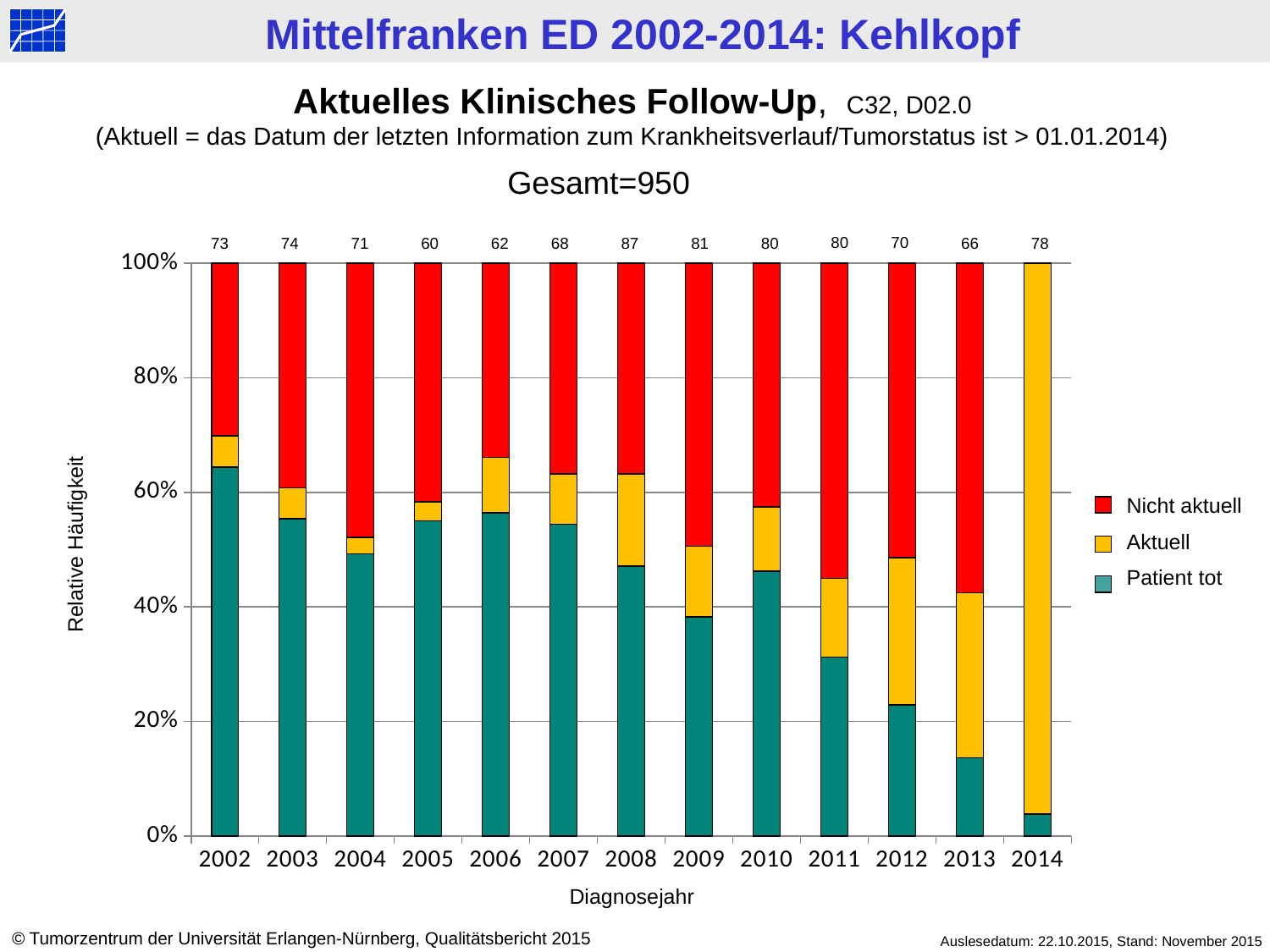
What number is printed above the bar for 2014? 78 Is the Patient tot share for 2013 greater or less than 20%? less Is the Patient tot share for 2002 greater or less than 60%? greater Which year has a larger number printed above its bar, 2003 or 2012? 2003 How many diagnosis years are shown on the x axis? 13 What number is printed above the bar for 2005? 60 How many series does the legend list? 3 What is the difference between the numbers printed above the bars for 2008 and 2005? 27 What kind of chart is shown on the slide? Stacked bar chart Which year has the lowest number printed above its bar? 2005 Which year has the highest number printed above its bar? 2008 What number is printed above the bar for 2008? 87